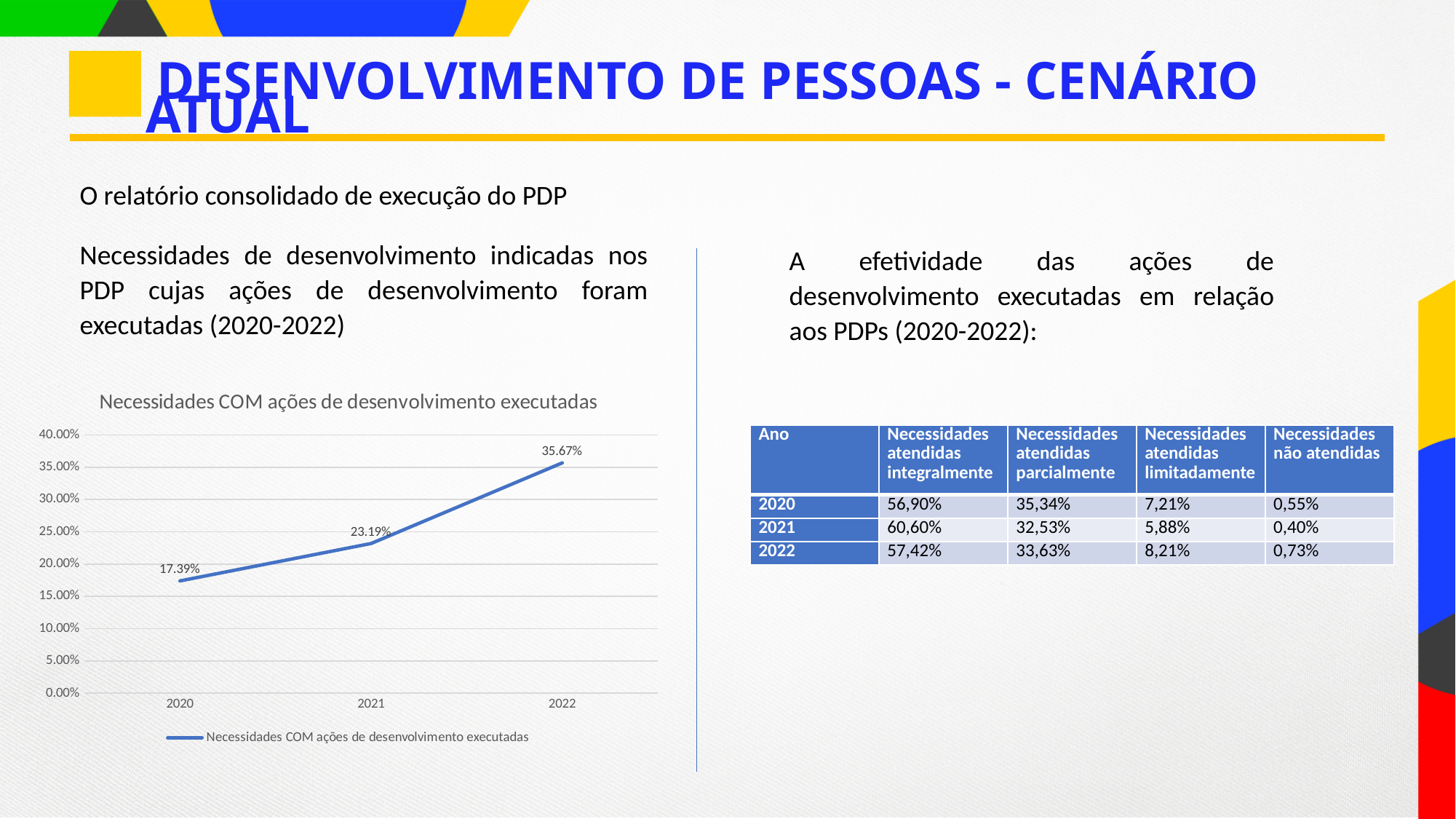
Do the values in the chart rise or fall from 2020 to 2022? Rise What is the difference between the values for 2022 and 2020 in the chart? 18.28% Which year has the lowest value in the chart? 2020 Is the value for 2021 in the chart greater or less than 25.00%? less Which is larger in the chart, the value for 2021 or the value for 2022? 2022 What is the value for 2020 in the chart? 17.39% What type of chart is shown on the slide? Line chart What is the difference between the values for 2021 and 2020 in the chart? 5.80% Which year has the highest value in the chart? 2022 What is the value for 2021 in the chart? 23.19% How many years are plotted on the x axis of the chart? 3 What is the value for 2022 in the chart? 35.67%